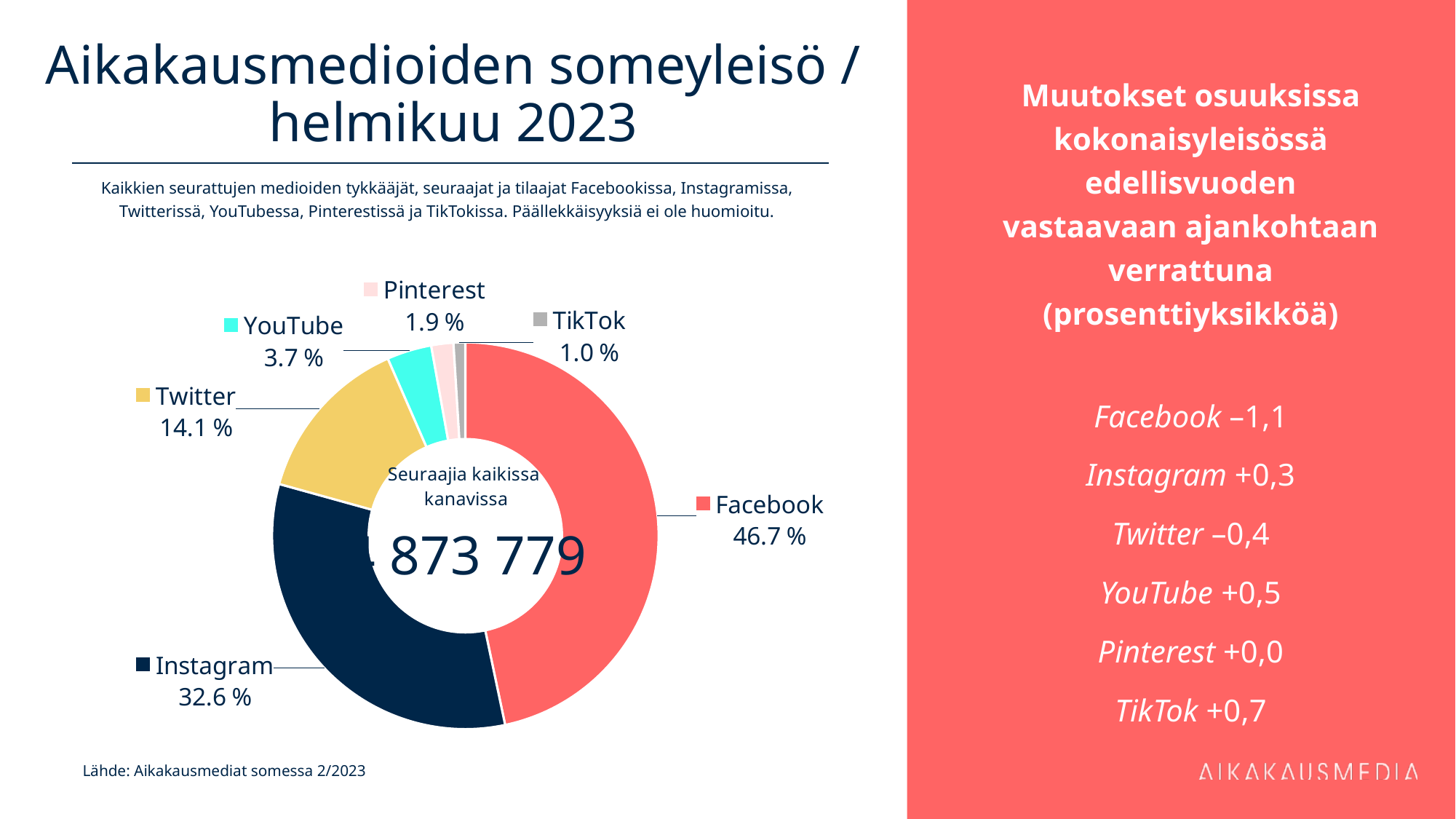
How many channels are shown in the chart? 6 What kind of chart is shown on the slide? Pie chart (donut) What share does Twitter have in the chart? 14.1 % How many percentage points larger is Facebook's share than Instagram's? 14.1 What share does Pinterest have in the chart? 1.9 % Which channel has the largest share of the audience? Facebook What share of the social media audience does Facebook have? 46.7 % Which channel has the smallest share of the audience? TikTok What share of the social media audience does Instagram have? 32.6 % What colour is the Twitter slice in the chart? Yellow What share does YouTube have in the chart? 3.7 % Which has a larger share, Twitter or YouTube? Twitter